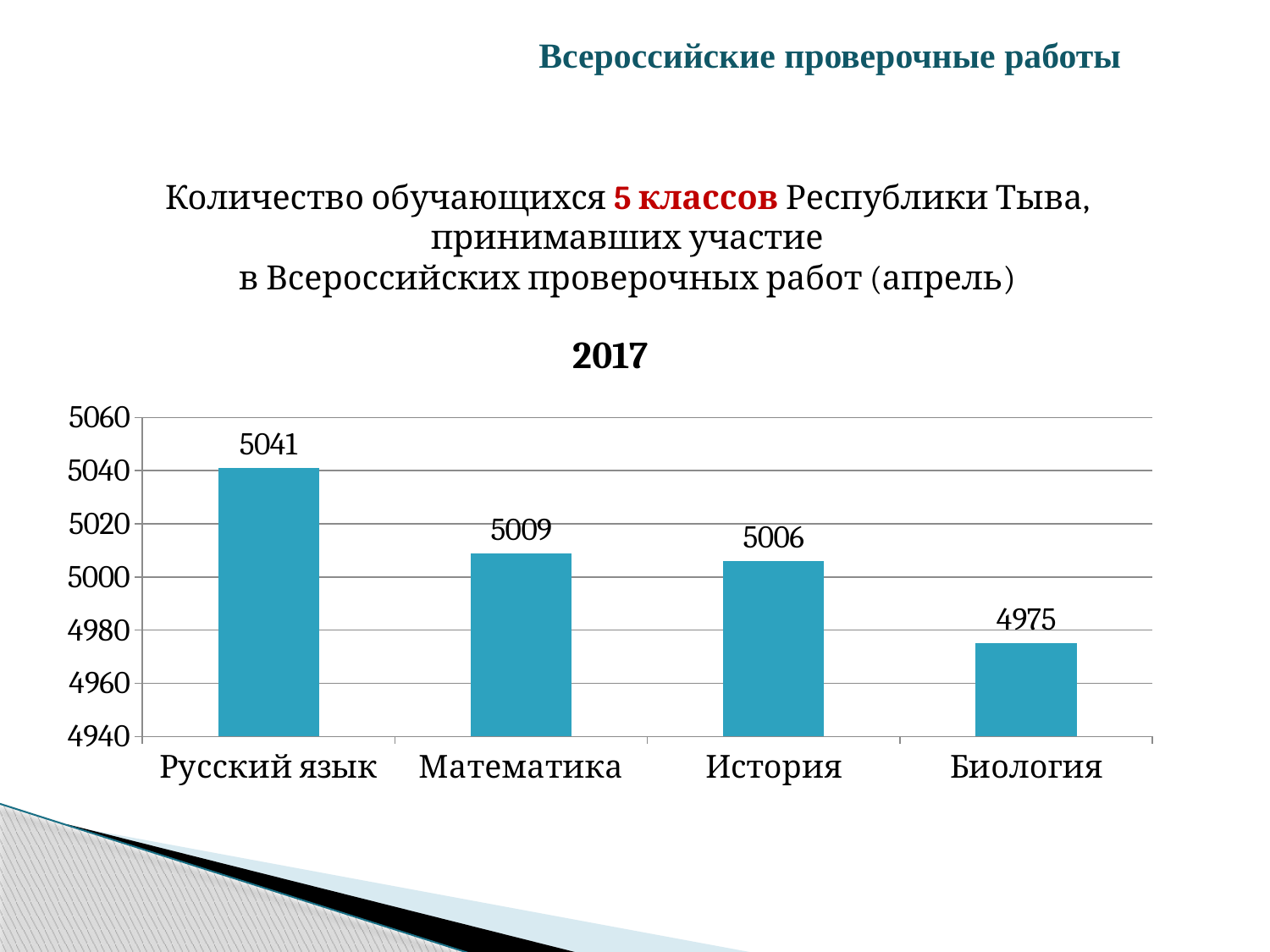
What is the value for Математика? 5009 Which category has the lowest value? Биология What is the difference between the values for Математика and История? 3 How many categories are shown on the x axis? 4 What is the value for Русский язык? 5041 Which is larger, the value for Русский язык or the value for Математика? Русский язык What is the value for Биология? 4975 What is the difference between the values for Русский язык and Биология? 66 Which category has the highest value? Русский язык What kind of chart is shown on the slide? bar chart What is the value for История? 5006 Is the value for Биология greater or less than 5000? less